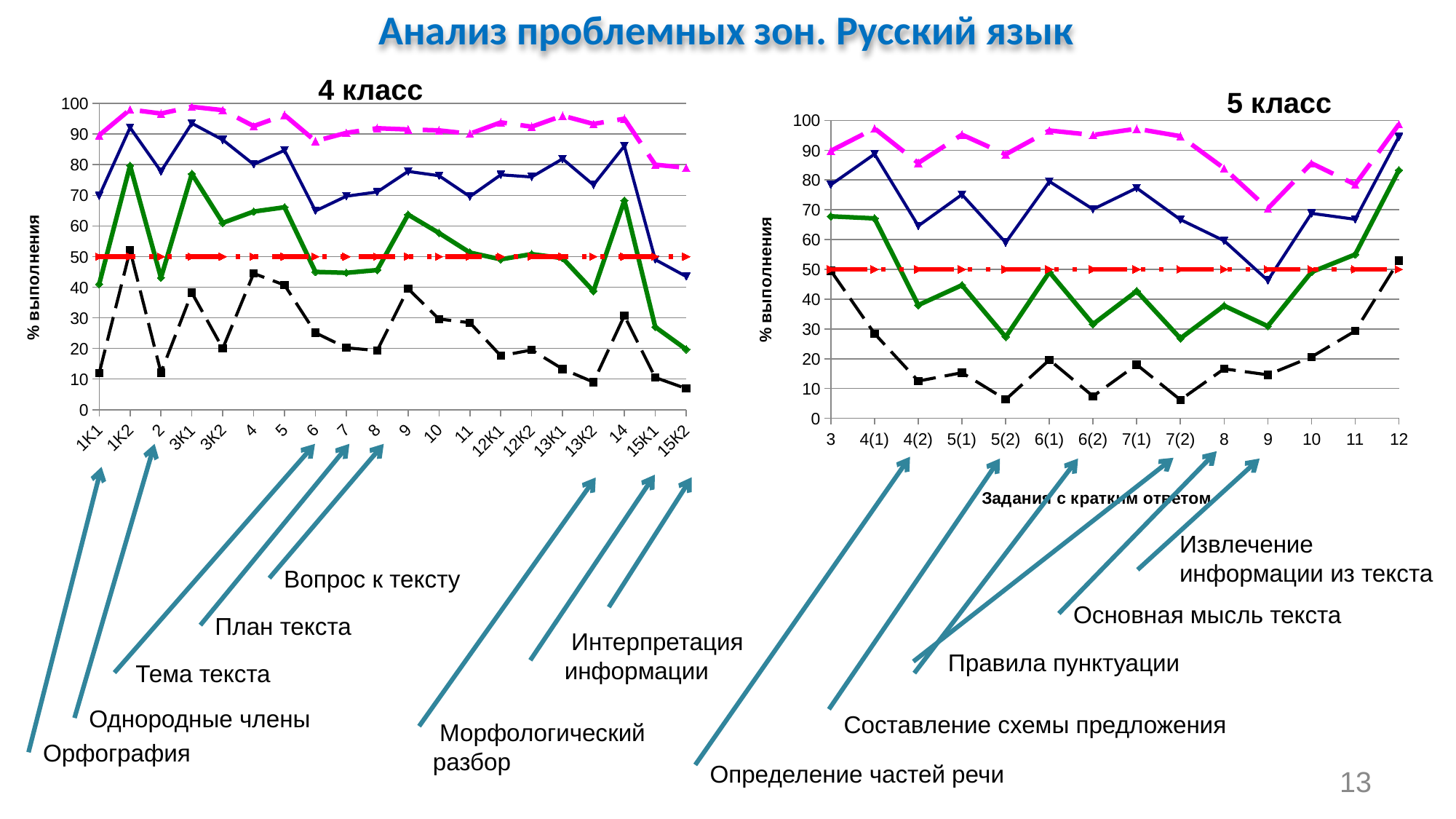
In the "5 класс" chart, is the value of the green line at 7(2) greater or less than 30? less In the "5 класс" chart, at which category is the green line highest? 12 How many categories are on the x axis of the "5 класс" chart? 14 In the "4 класс" chart, is the value of the black dashed line at 1К1 greater or less than 20? less What kind of chart is the "4 класс" chart? line chart In the "4 класс" chart, is the black dashed line higher at 1К2 or at 2? 1К2 In the "4 класс" chart, at which category is the dark blue line lowest? 15К2 How many categories are on the x axis of the "4 класс" chart? 20 What is the x-axis title of the "5 класс" chart? Задания с кратким ответом In the "4 класс" chart, at what constant value does the red dashed line run? 50 In the "4 класс" chart, is the value of the pink dashed line at 3К1 greater or less than 90? greater In the "5 класс" chart, at which category is the pink dashed line lowest? 9